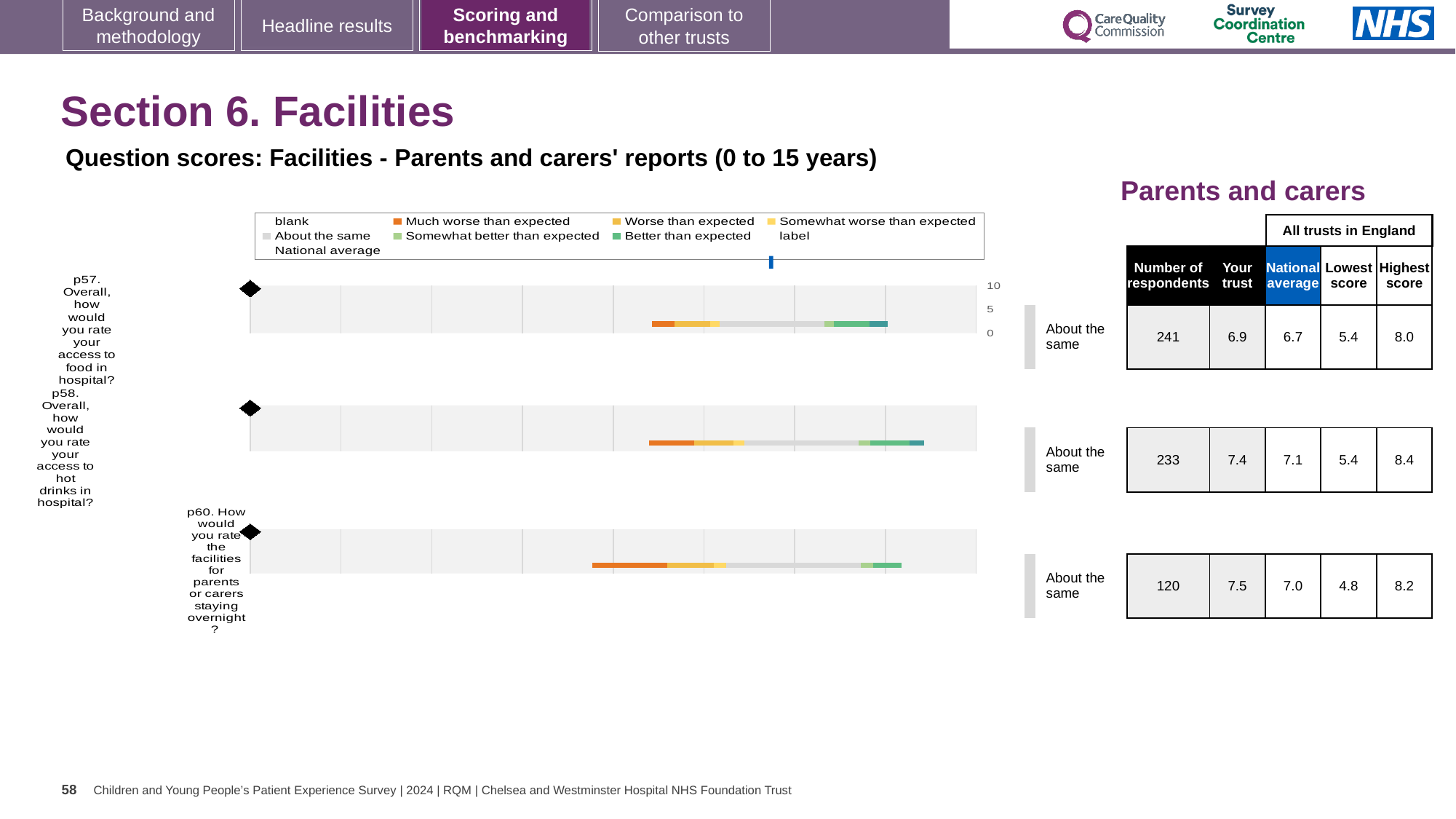
How many respondents answered p60 (facilities for parents or carers staying overnight)? 120 Which question has the highest 'Your trust' score? p60 How many entries does the chart legend list? 9 How many survey questions are plotted in the chart? 3 For p57, which is larger: the 'Your trust' score or the national average? Your trust What is the national average score for p58 (access to hot drinks in hospital)? 7.1 Which question has the lowest number of respondents? p60 What is the highest score across all trusts in England for p58? 8.4 What kind of chart is used to show the question scores on this slide? bar chart What benchmark category is shown for all three questions? About the same What is the difference between the 'Your trust' score and the national average for p58? 0.3 What is the 'Your trust' score for p57 (access to food in hospital)? 6.9